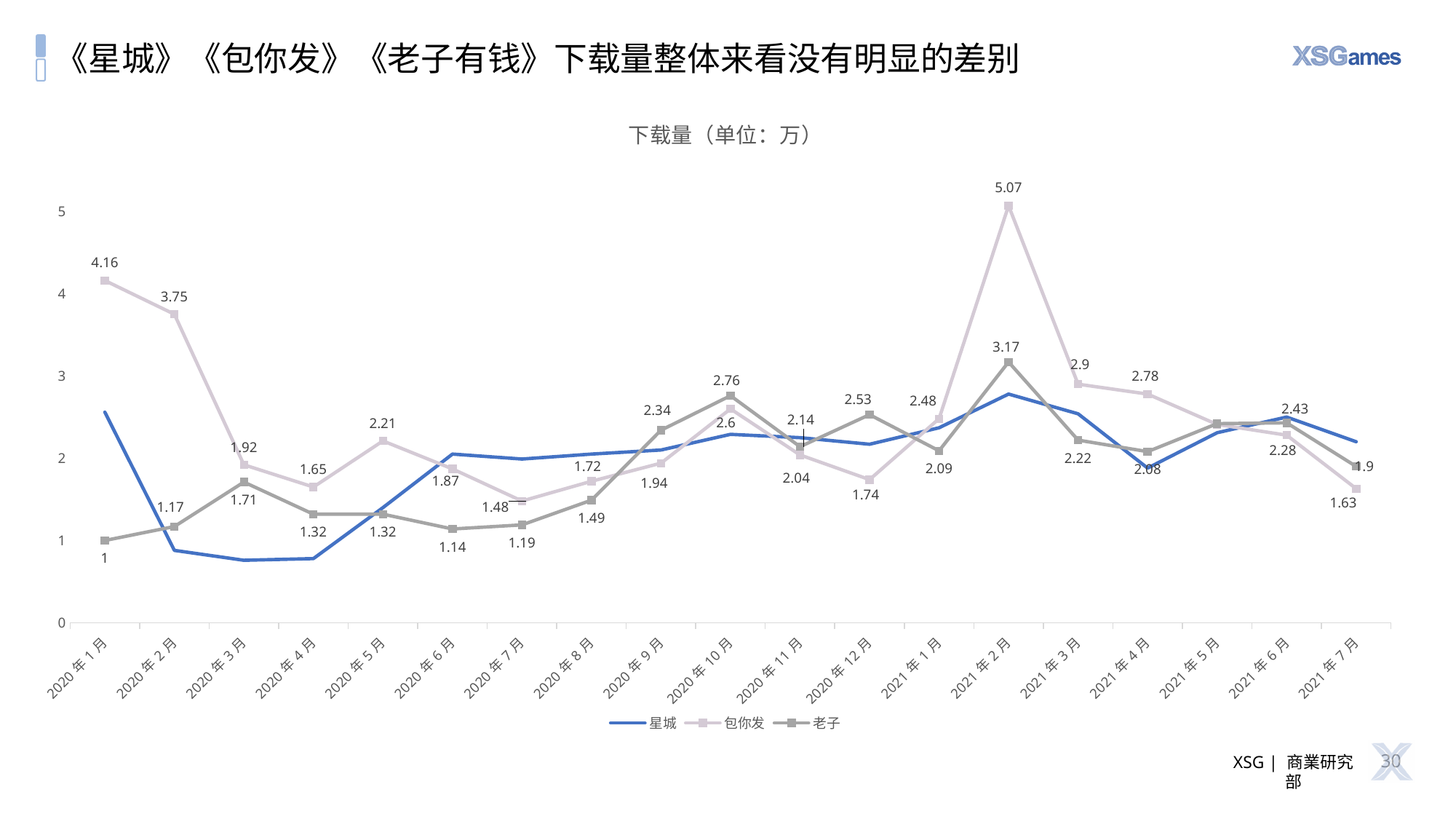
What kind of chart is shown on the slide? line chart In which month does 老子 have its lowest value? 2020年1月 How many months are shown on the x axis? 19 In which month does 包你发 reach its highest value? 2021年2月 Is the value for 星城 in 2020年3月 greater or less than 1? less In 2020年9月, which series has the larger value, 老子 or 包你发? 老子 What is the value for 包你发 in 2021年2月? 5.07 How many series does the legend list? 3 What is the value for 老子 in 2020年10月? 2.76 What is the value for 老子 in 2021年7月? 1.9 What is the difference between the 包你发 values for 2020年1月 and 2020年2月? 0.41 What is the difference between the 老子 values for 2021年2月 and 2021年3月? 0.95